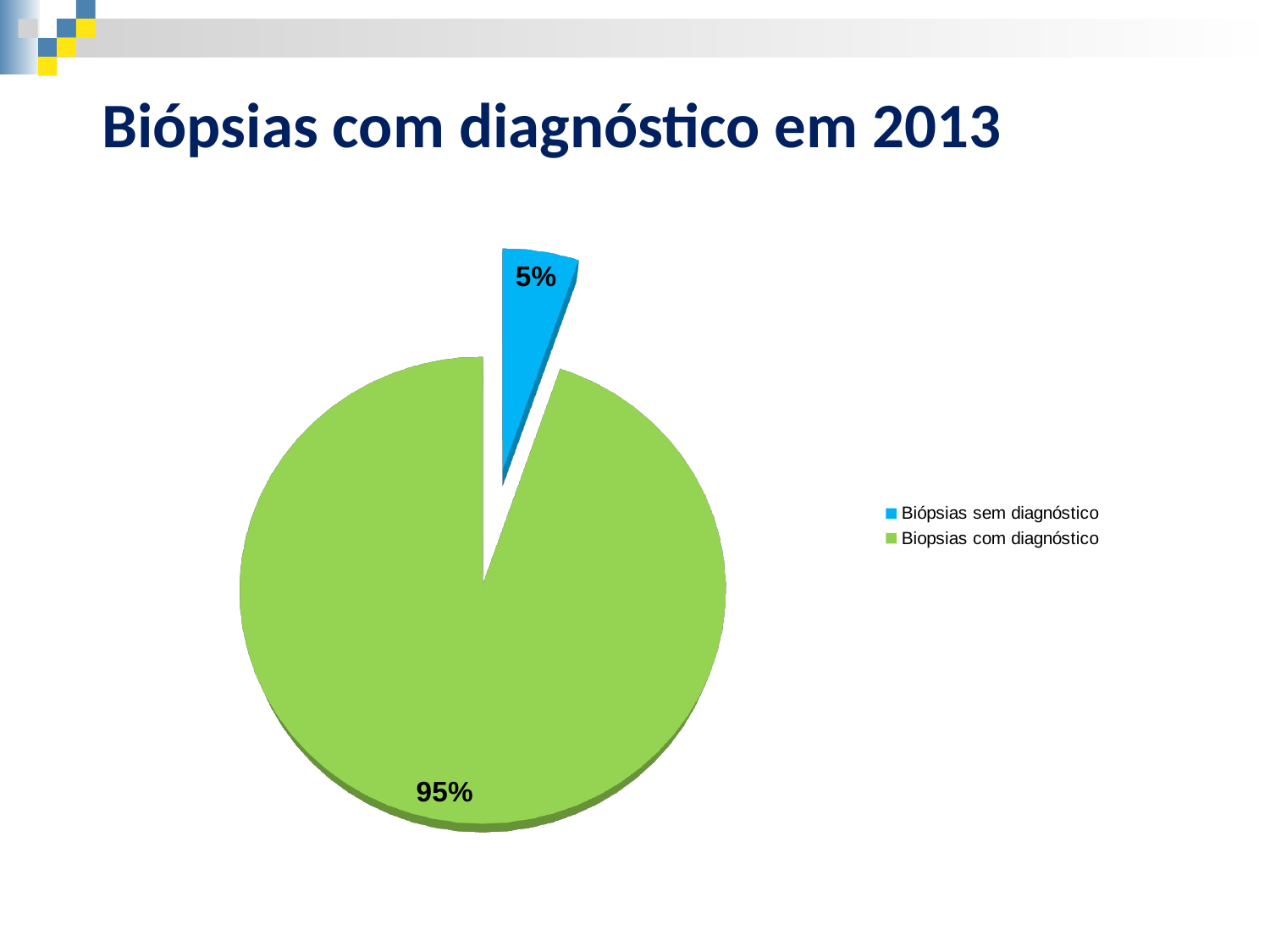
Which slice is the smallest? Biópsias sem diagnóstico What is the title of the slide containing the pie chart? Biópsias com diagnóstico em 2013 What share of the pie is labelled "Biopsias com diagnóstico"? 95% What share of the pie is labelled "Biópsias sem diagnóstico"? 5% How many entries does the legend list? 2 What colour is the "Biópsias sem diagnóstico" slice? blue How many slices does the pie chart have? 2 What kind of chart is shown on the slide? pie chart What is the difference in percentage points between the "Biopsias com diagnóstico" slice and the "Biópsias sem diagnóstico" slice? 90 Which slice is the largest? Biopsias com diagnóstico Which is larger: the "Biópsias sem diagnóstico" slice or the "Biopsias com diagnóstico" slice? Biopsias com diagnóstico